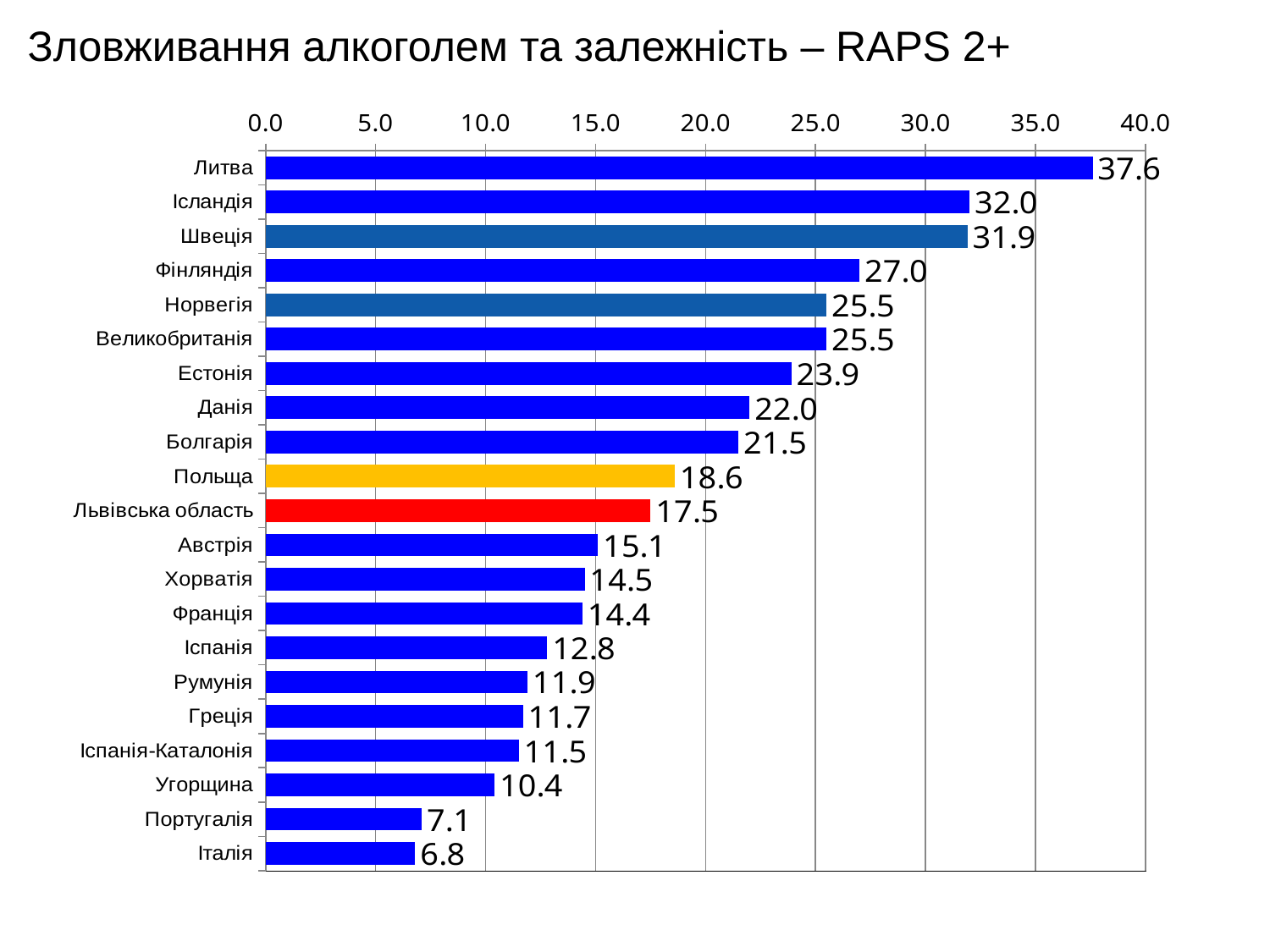
What is the value for Польща? 18.6 What is the difference between the values for Литва and Ісландія? 5.6 Is the value for Угорщина greater or less than 15.0? less Which category has the highest value? Литва What kind of chart is shown on the slide? bar chart What is the value for Львівська область? 17.5 Which category has the lowest value? Італія What is the value for Литва? 37.6 How many categories are shown in the chart? 21 What is the difference between the values for Польща and Львівська область? 1.1 Which is larger, the value for Фінляндія or the value for Естонія? Фінляндія What is the title of the chart? Зловживання алкоголем та залежність – RAPS 2+